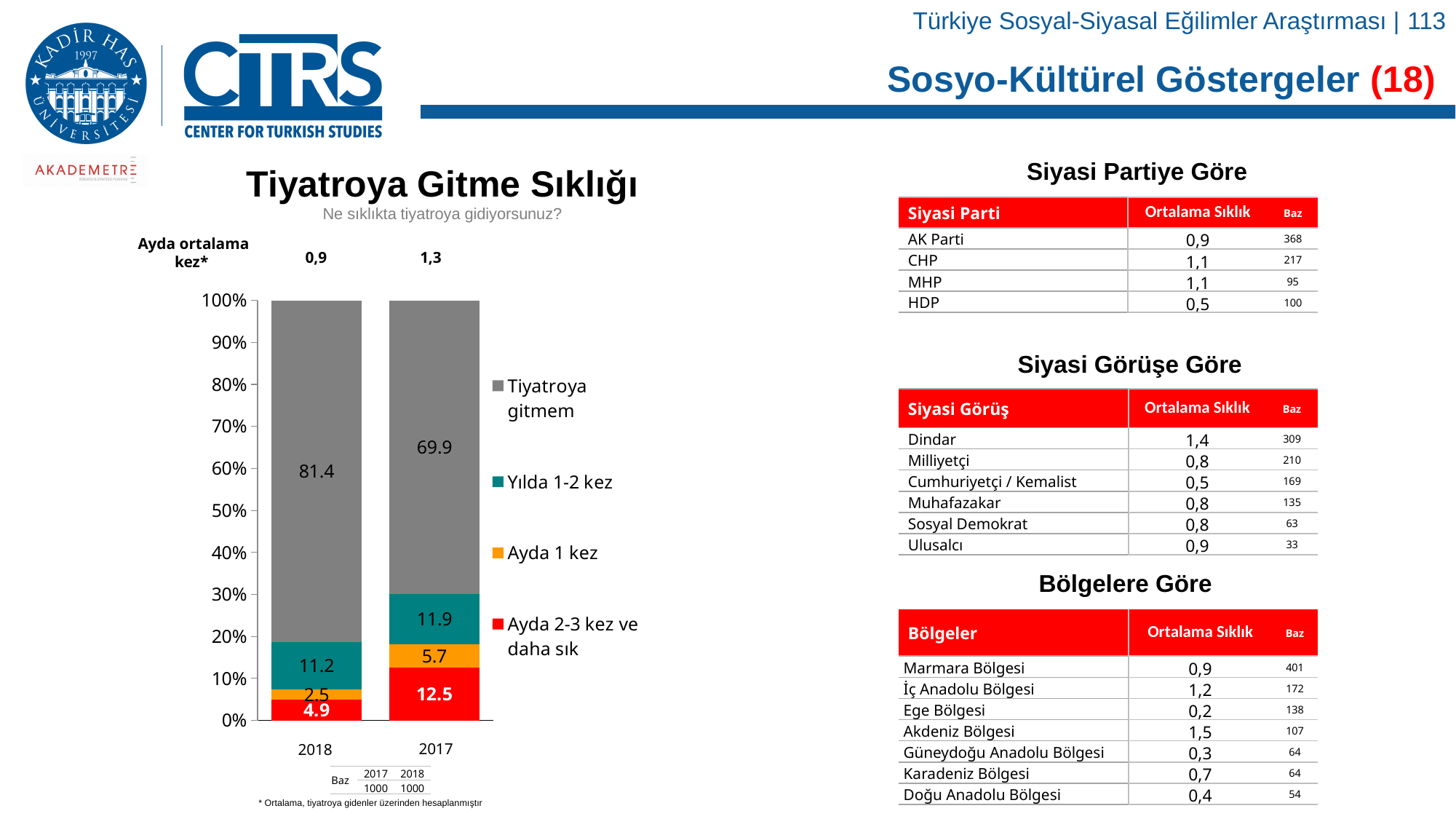
How many series does the chart legend list? 4 What is the value for "Ayda 2-3 kez ve daha sık" in the 2017 bar? 12.5 What is the difference between the "Tiyatroya gitmem" values for 2018 and 2017? 11.5 Which segment is the smallest in the 2018 bar? Ayda 1 kez What kind of chart is shown on the slide? stacked bar chart What is the value for "Yılda 1-2 kez" in the 2018 bar? 11.2 What is the title of the chart? Tiyatroya Gitme Sıklığı Which year has the larger value for "Ayda 2-3 kez ve daha sık", 2018 or 2017? 2017 What is the value for "Ayda 1 kez" in the 2017 bar? 5.7 Which segment is the largest in the 2017 bar? Tiyatroya gitmem What is the value for "Tiyatroya gitmem" in the 2018 bar? 81.4 How many bars (years) are plotted in the chart? 2